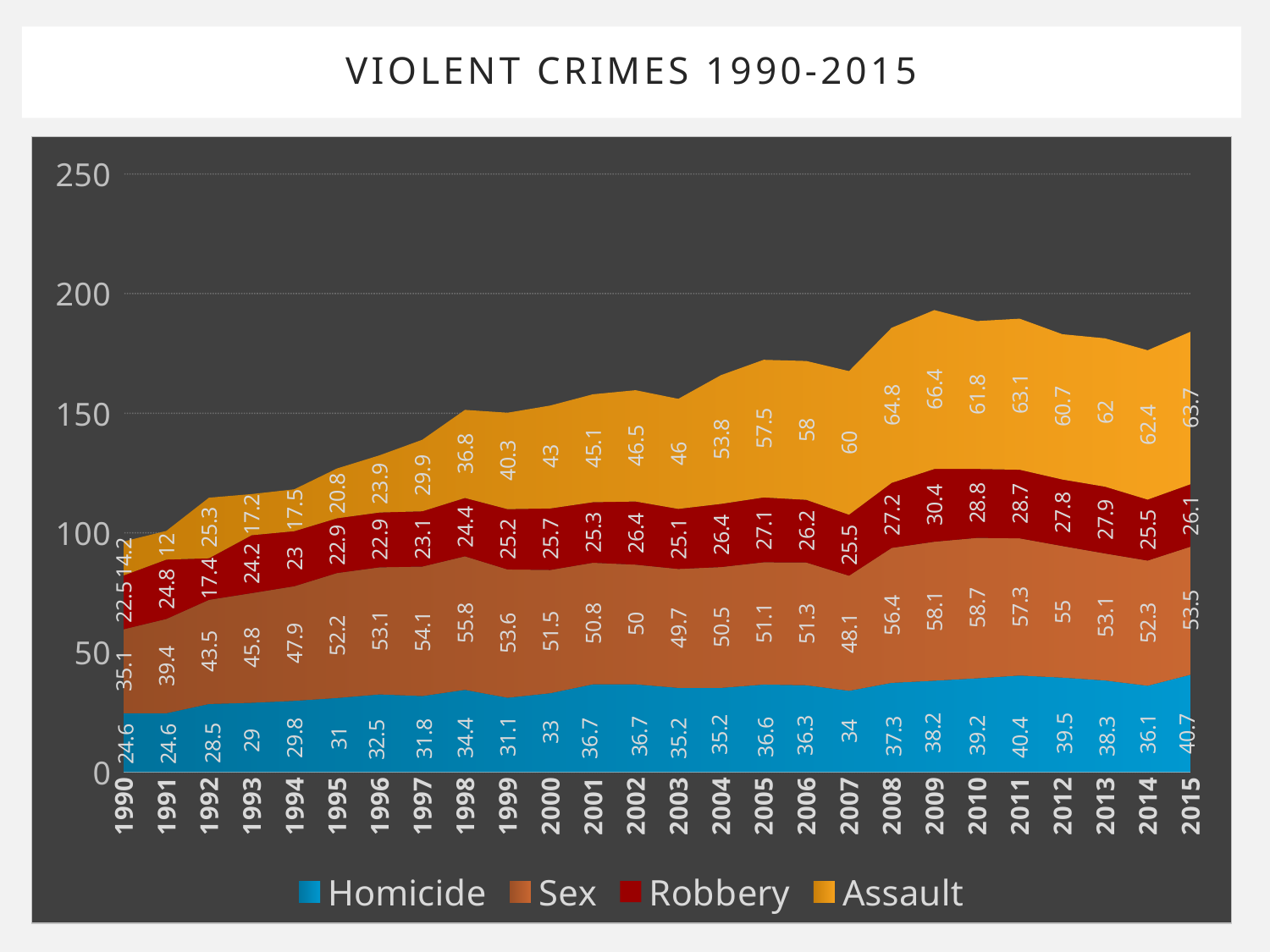
Does the Assault value generally rise or fall from 1990 to 2015? Rise What is the Assault value for 2009? 66.4 What type of chart is shown on the slide? Stacked area chart What is the Robbery value for 2014? 25.5 In which year is the Assault value highest? 2009 What is the Homicide value for 1990? 24.6 What is the difference between the Sex value in 2010 and in 1990? 23.6 What is the total of all four series for 2015? 184 Which is larger, the Robbery value in 2009 or in 1992? 2009 In which year is the Assault value lowest? 1991 How many series does the legend list? 4 How many years are plotted on the x axis? 26